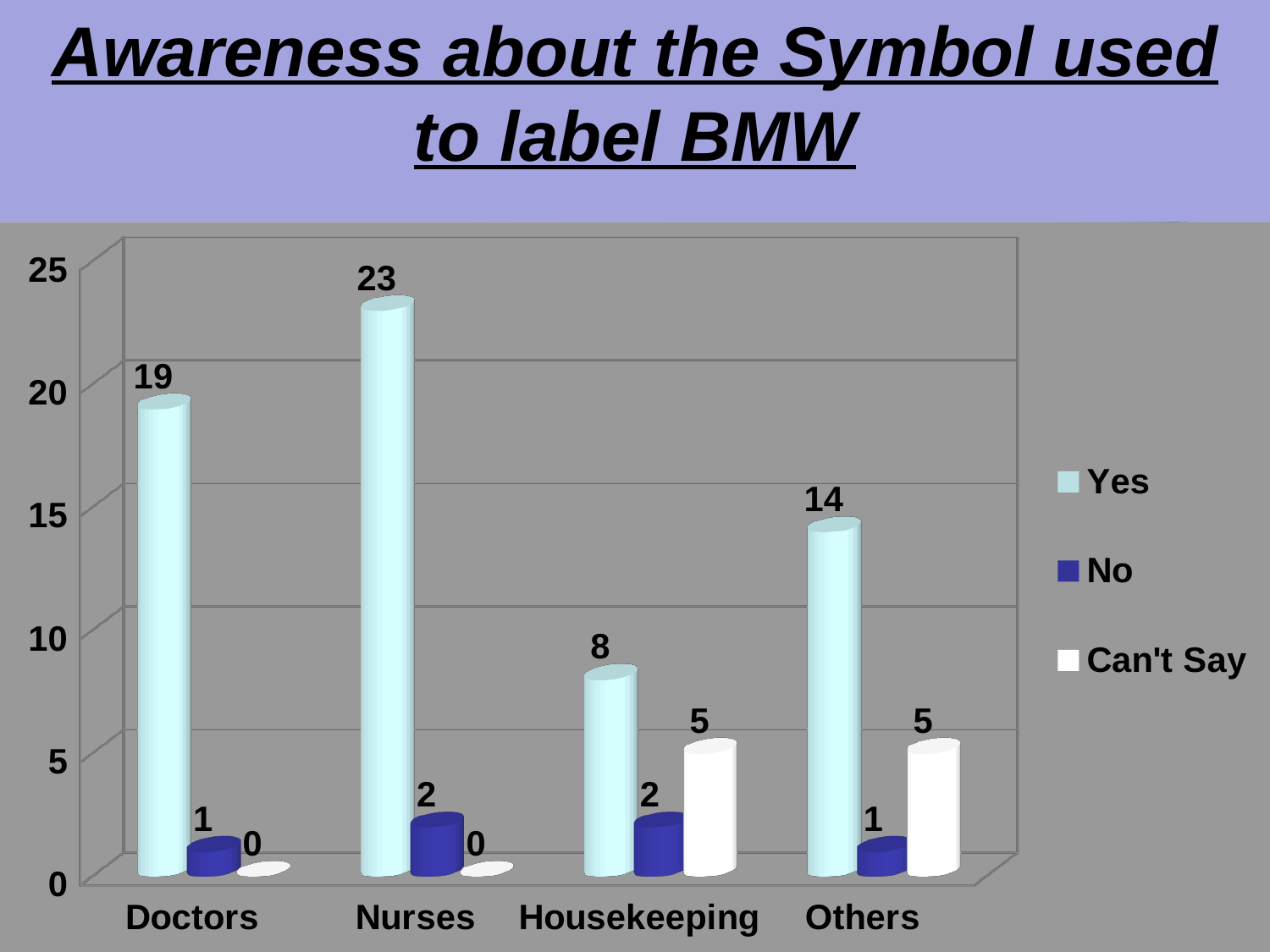
What is the 'Can't Say' value for Housekeeping? 5 How many series does the legend list? 3 What kind of chart is shown on the slide? Bar chart What is the difference between the 'Yes' values for Nurses and Doctors? 4 What is the 'Yes' value for Nurses? 23 How many categories are shown on the x axis? 4 Which category has the lowest 'Yes' value? Housekeeping What is the 'No' value for Doctors? 1 Which is larger, the 'Yes' value for Others or the 'Yes' value for Housekeeping? Others What is the title of the slide? Awareness about the Symbol used to label BMW What is the total of the three values for Others? 20 Which category has the highest 'Yes' value? Nurses